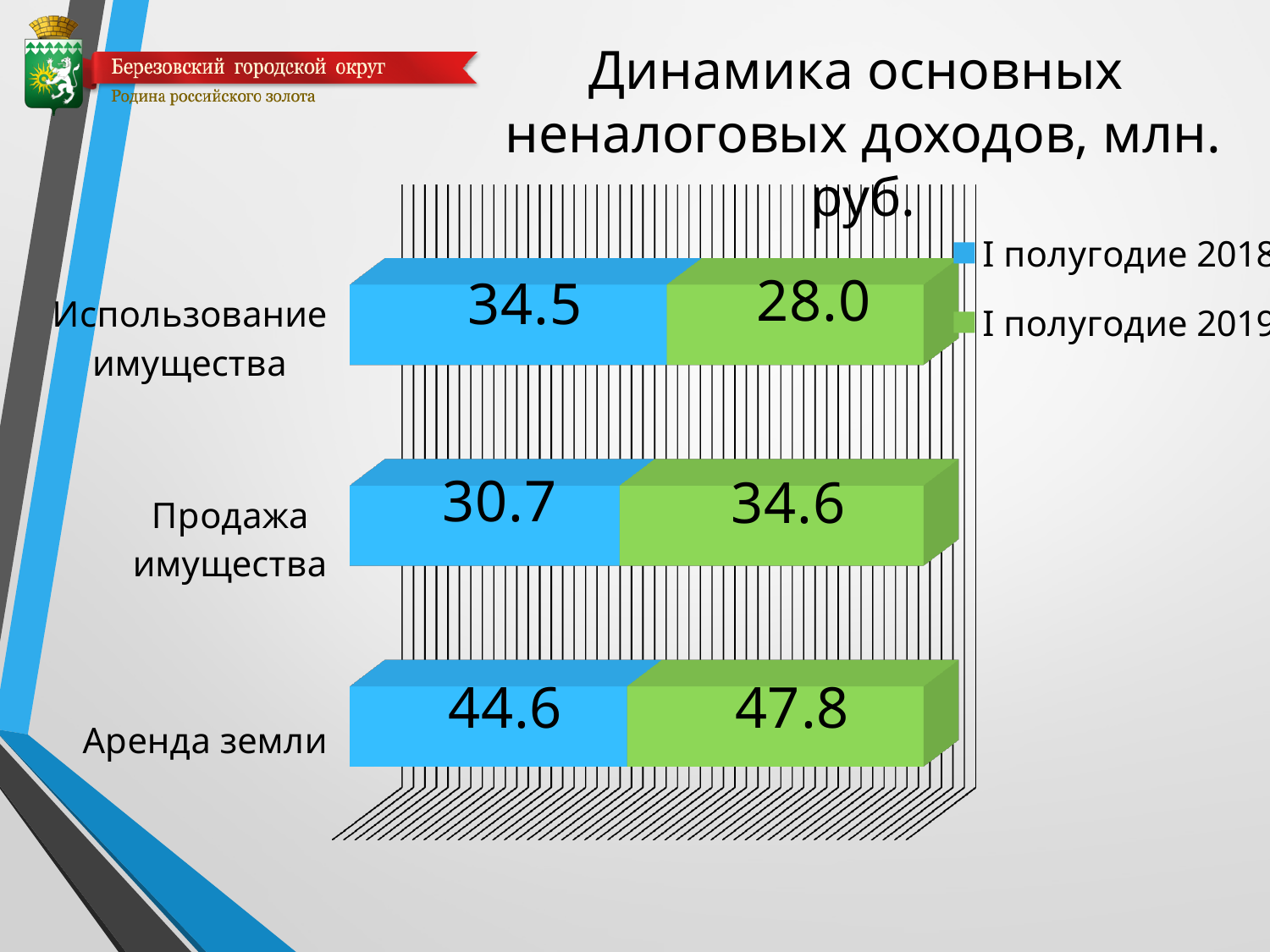
What is the value for Использование имущества in I полугодие 2018? 34.5 For Использование имущества, which is larger: the I полугодие 2018 value or the I полугодие 2019 value? I полугодие 2018 What is the difference between the I полугодие 2019 and I полугодие 2018 values for Аренда земли? 3.2 How many categories are shown in the chart? 3 Which category has the highest value in I полугодие 2019? Аренда земли What is the total of the stacked bar for Продажа имущества? 65.3 What kind of chart is shown on the slide? Stacked bar chart What is the value for Использование имущества in I полугодие 2019? 28.0 How many series does the legend list? 2 What is the value for Аренда земли in I полугодие 2018? 44.6 What is the value for Продажа имущества in I полугодие 2019? 34.6 Which category has the lowest value in I полугодие 2018? Продажа имущества